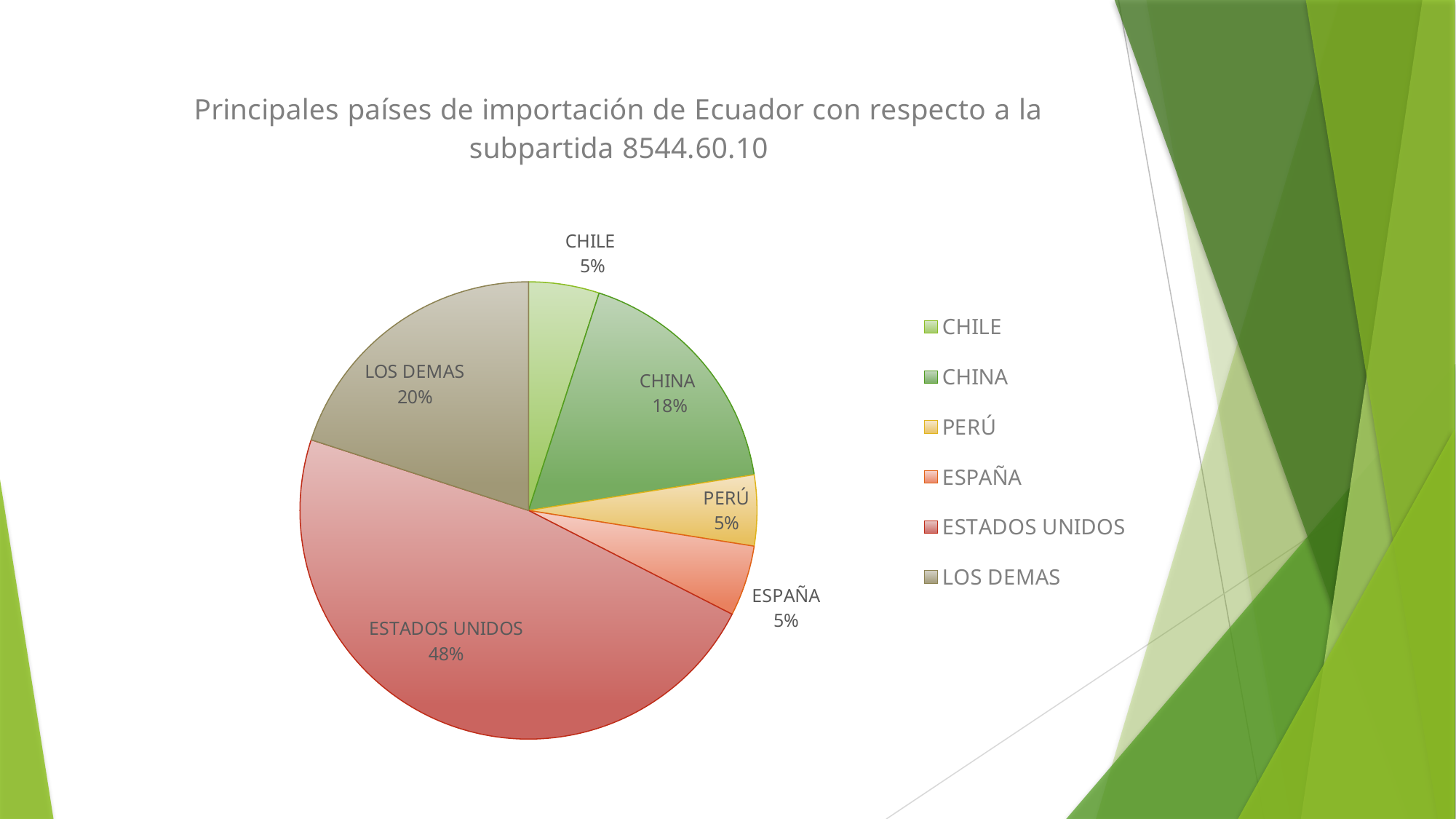
How many entries does the legend list? 6 What share of the pie does LOS DEMAS have? 20% What is the value shown for PERÚ? 5% What share of the pie does CHINA have? 18% How many slices does the pie chart have? 6 What share of the pie does ESTADOS UNIDOS have? 48% What is the title of the chart? Principales países de importación de Ecuador con respecto a la subpartida 8544.60.10 Which category has the largest slice of the pie? ESTADOS UNIDOS Which is larger, the share for CHINA or the share for LOS DEMAS? LOS DEMAS What is the difference between the shares of CHINA and CHILE? 13% What kind of chart is shown on the slide? pie chart What is the difference between the shares of ESTADOS UNIDOS and LOS DEMAS? 28%